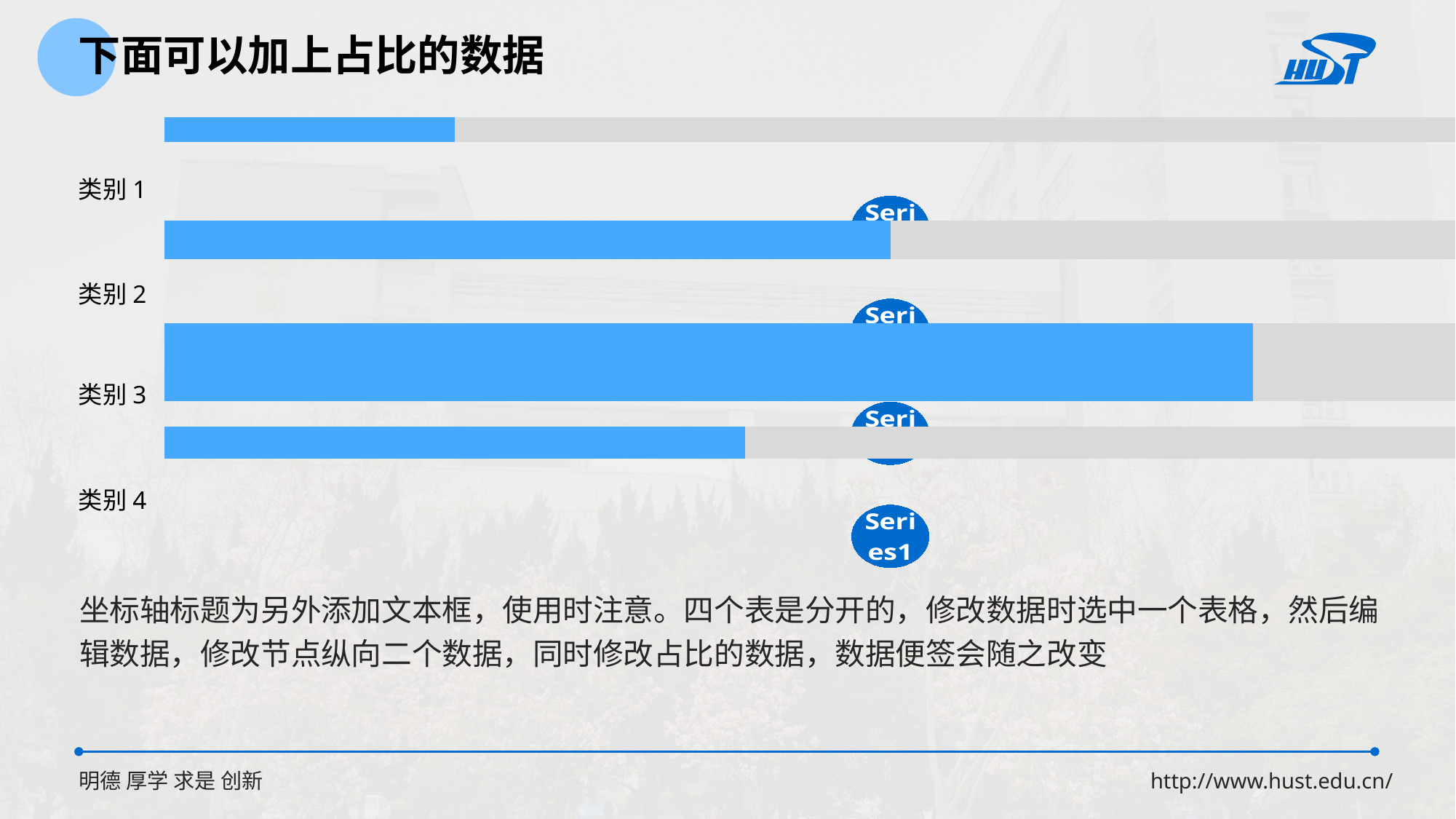
Which category has the shortest blue bar? 类别 1 Which has the longer blue bar, 类别 2 or 类别 4? 类别 2 What series name is shown in the legend below the bars? Series1 Which category has the longest blue bar? 类别 3 What is the title of the slide containing the chart? 下面可以加上占比的数据 Which has the longer blue bar, 类别 1 or 类别 4? 类别 4 Which has the longer blue bar, 类别 1 or 类别 3? 类别 3 What kind of chart is shown on the slide? bar chart How many categories are shown in the bar chart? 4